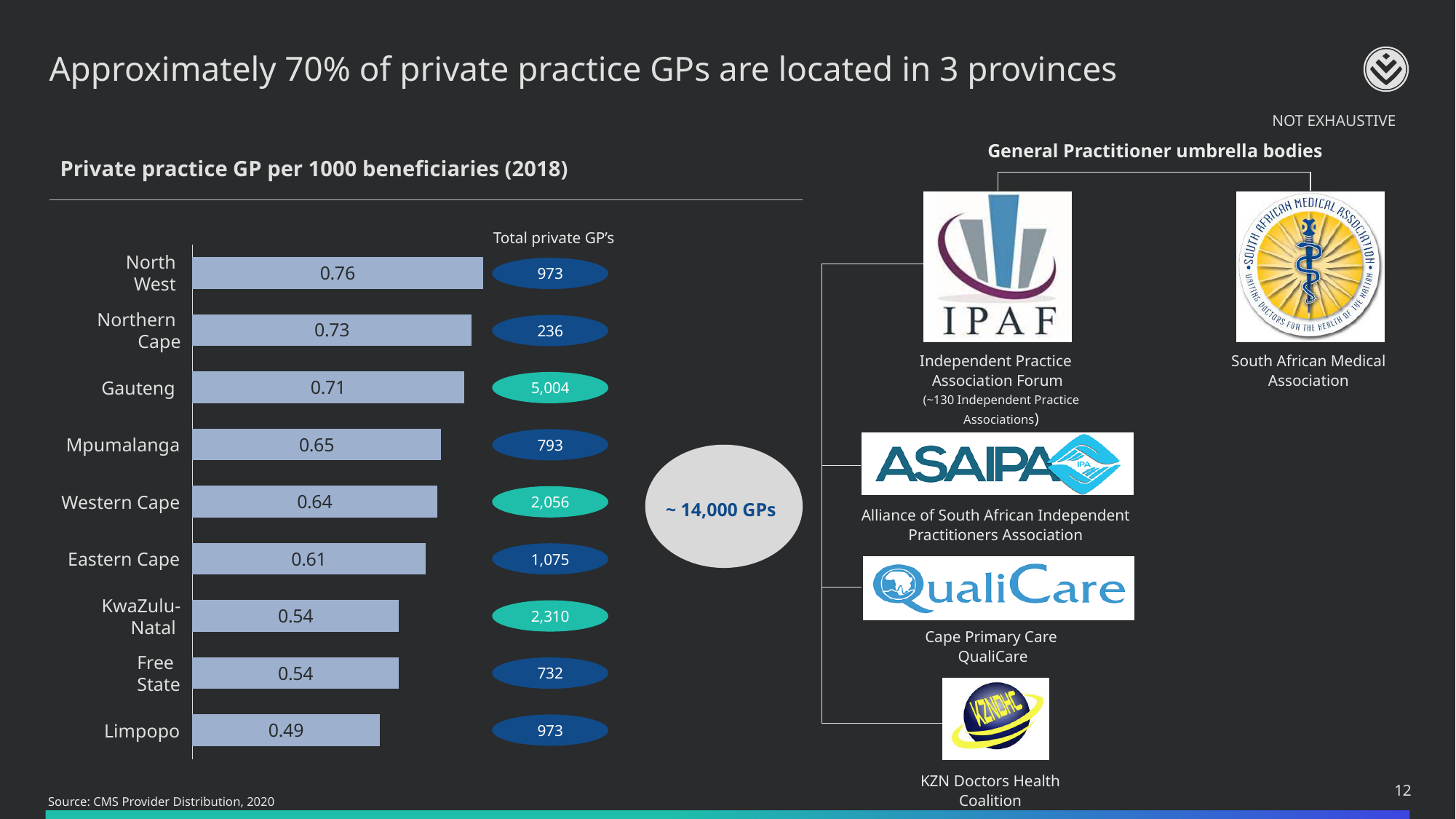
What is the difference between the values for North West and Limpopo in the GP per 1000 beneficiaries chart? 0.27 What kind of chart is used to show private practice GP per 1000 beneficiaries? Bar chart What is the title of the bar chart on the slide? Private practice GP per 1000 beneficiaries (2018) What is the value for Limpopo in the Private practice GP per 1000 beneficiaries chart? 0.49 What is the total number of private GP's shown for Northern Cape? 236 Which has a higher GP per 1000 beneficiaries value, Mpumalanga or Western Cape? Mpumalanga What is the total number of private GP's shown for Gauteng? 5,004 Which province has the highest private practice GP per 1000 beneficiaries? North West How many provinces are shown in the Private practice GP per 1000 beneficiaries chart? 9 Do the GP per 1000 beneficiaries values increase or decrease going from the top bar to the bottom bar? Decrease What is the value for Gauteng in the Private practice GP per 1000 beneficiaries (2018) chart? 0.71 Which province has the lowest private practice GP per 1000 beneficiaries? Limpopo